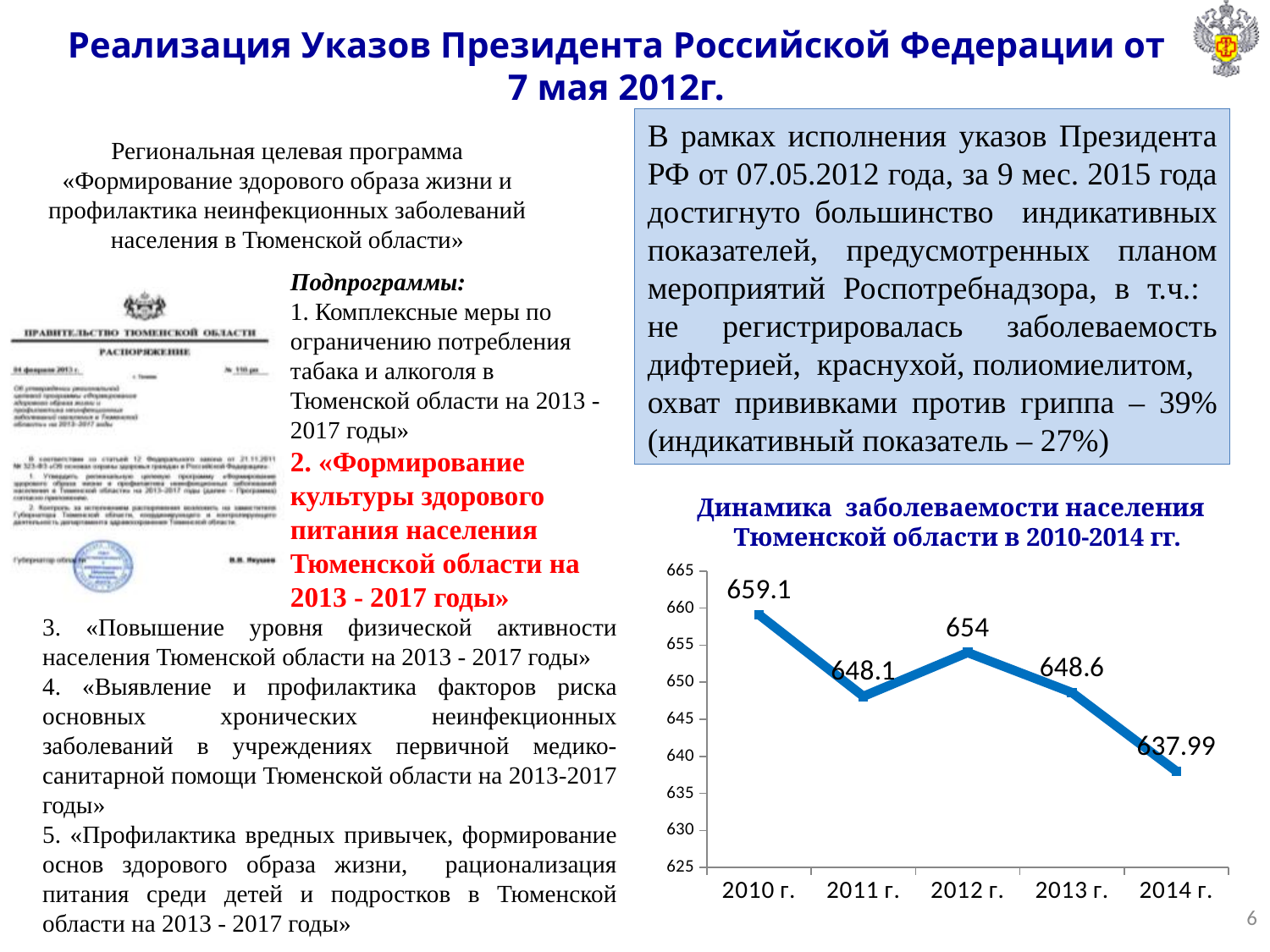
What is the difference between the values for 2010 г. and 2014 г.? 21.11 What is the value for 2012 г. in the chart? 654 How many years are plotted in the chart? 5 What kind of chart is shown on the slide? line chart What is the value for 2010 г. in the chart? 659.1 Which year has the highest value in the chart? 2010 г. What is the title of the chart? Динамика заболеваемости населения Тюменской области в 2010-2014 гг. What is the value for 2014 г. in the chart? 637.99 Which is larger, the value for 2012 г. or the value for 2014 г.? 2012 г. What is the difference between the values for 2012 г. and 2011 г.? 5.9 Is the value for 2013 г. greater or less than 650? less Which year has the lowest value in the chart? 2014 г.